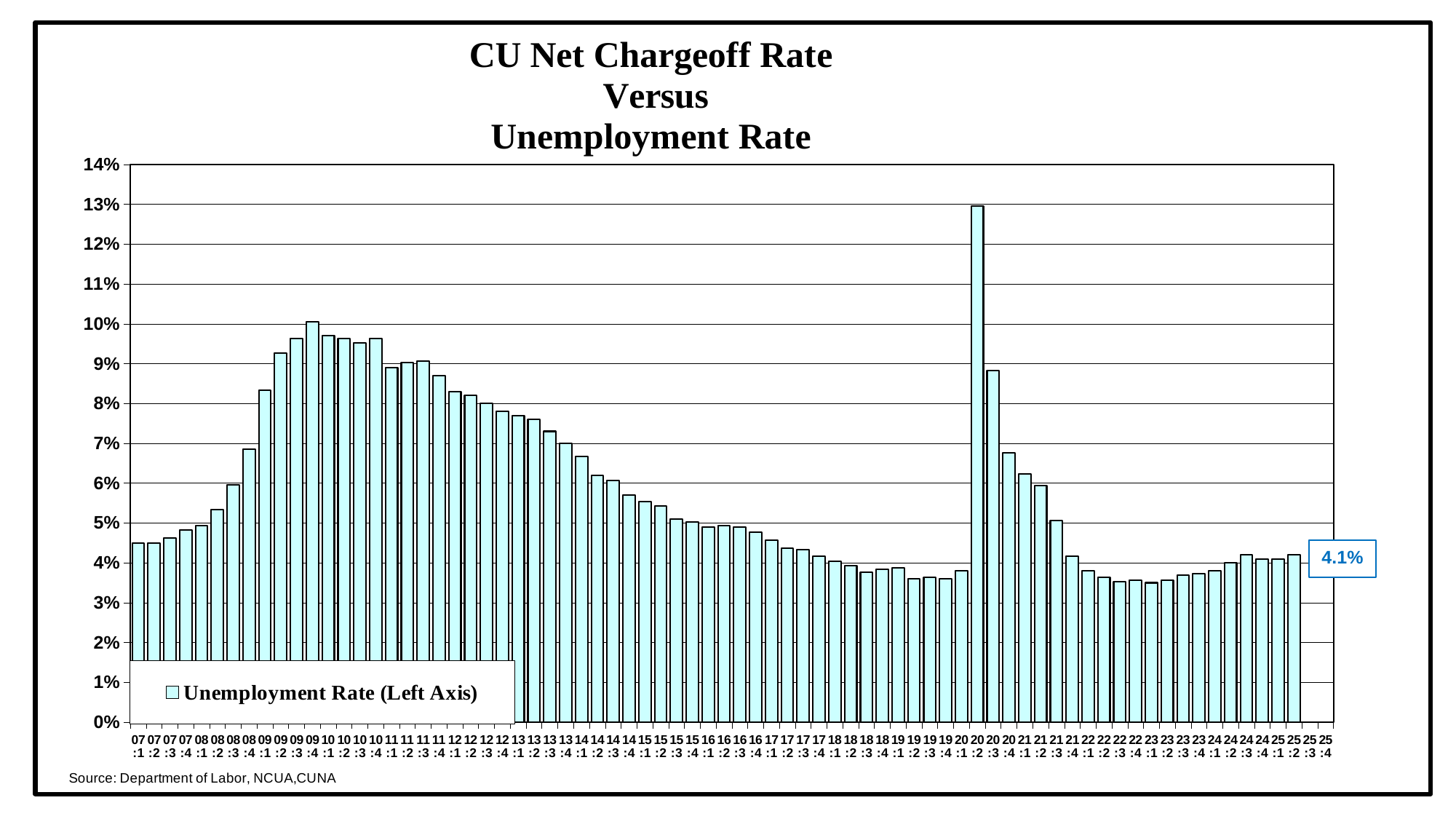
What series name appears in the legend? Unemployment Rate (Left Axis) What type of chart is shown on the slide? bar chart Is the value for 20:2 greater or less than 12%? greater What is the title of the chart? CU Net Chargeoff Rate Versus Unemployment Rate Do the values rise or fall from 09:4 to 19:4? fall Which is larger, the value for 20:3 or the value for 21:1? 20:3 How many series does the legend list? 1 Is the value for 13:1 greater or less than 7%? greater Which quarter has the highest unemployment rate? 20:2 What is the unemployment rate value labeled on the last bar (25:2)? 4.1% Is the value for 07:1 greater or less than 5%? less